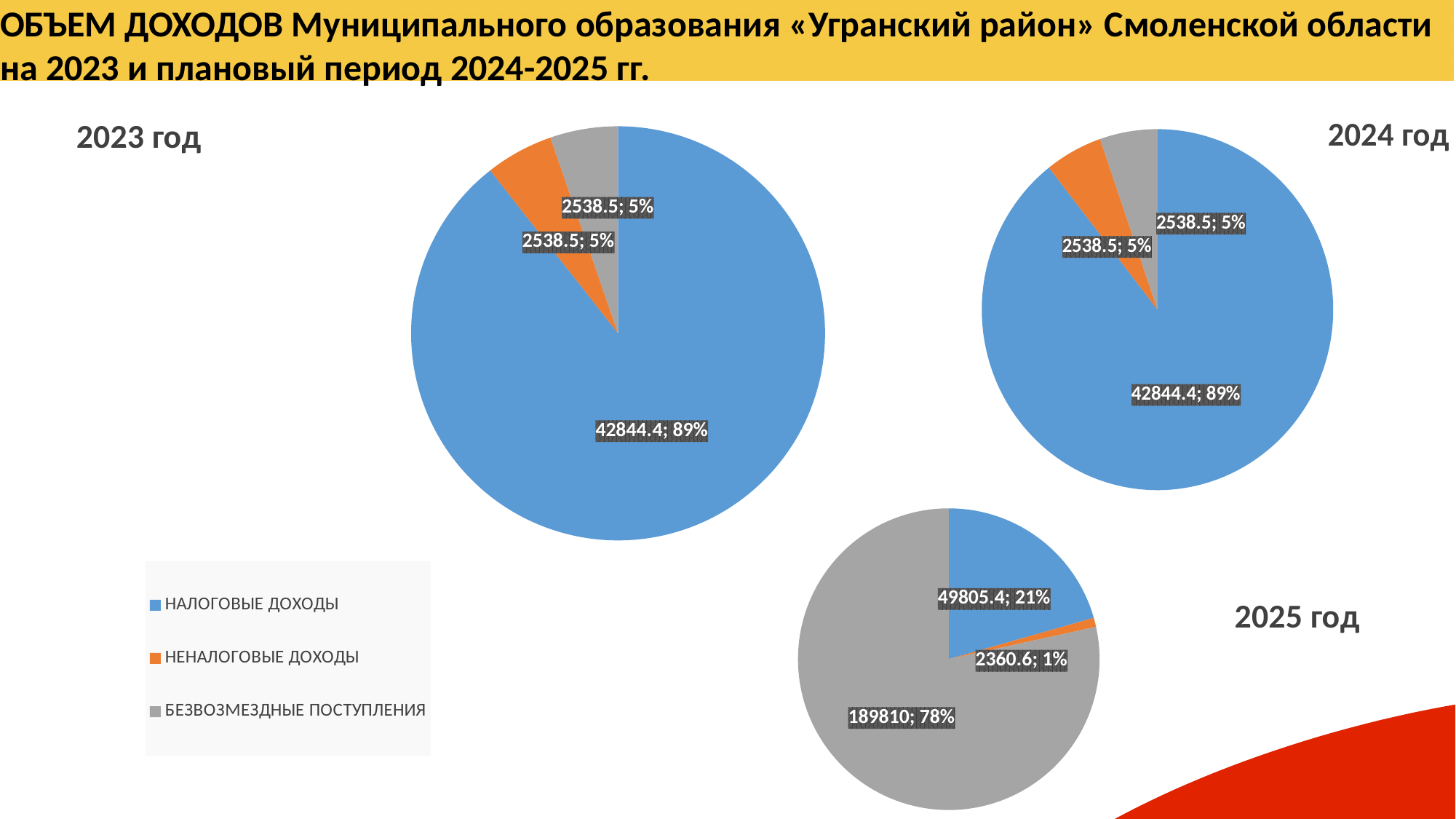
In the 2023 год chart, what is the value for НАЛОГОВЫЕ ДОХОДЫ? 42844.4 In the 2025 год chart, which category is the smallest? НЕНАЛОГОВЫЕ ДОХОДЫ In the 2025 год chart, which is larger: НАЛОГОВЫЕ ДОХОДЫ or БЕЗВОЗМЕЗДНЫЕ ПОСТУПЛЕНИЯ? БЕЗВОЗМЕЗДНЫЕ ПОСТУПЛЕНИЯ Which colour represents НЕНАЛОГОВЫЕ ДОХОДЫ in the legend? orange In the 2024 год chart, what is the value for НЕНАЛОГОВЫЕ ДОХОДЫ? 2538.5 In the 2025 год chart, what is the value for БЕЗВОЗМЕЗДНЫЕ ПОСТУПЛЕНИЯ? 189810 In the 2025 год chart, what is the difference between БЕЗВОЗМЕЗДНЫЕ ПОСТУПЛЕНИЯ and НАЛОГОВЫЕ ДОХОДЫ? 140004.6 In the 2023 год chart, what share of the pie is НАЛОГОВЫЕ ДОХОДЫ? 89% In the 2025 год chart, what share of the pie is НЕНАЛОГОВЫЕ ДОХОДЫ? 1% In the 2025 год chart, which category is the largest? БЕЗВОЗМЕЗДНЫЕ ПОСТУПЛЕНИЯ What kind of chart is used for the 2023 год data? pie chart How many categories does the legend list? 3